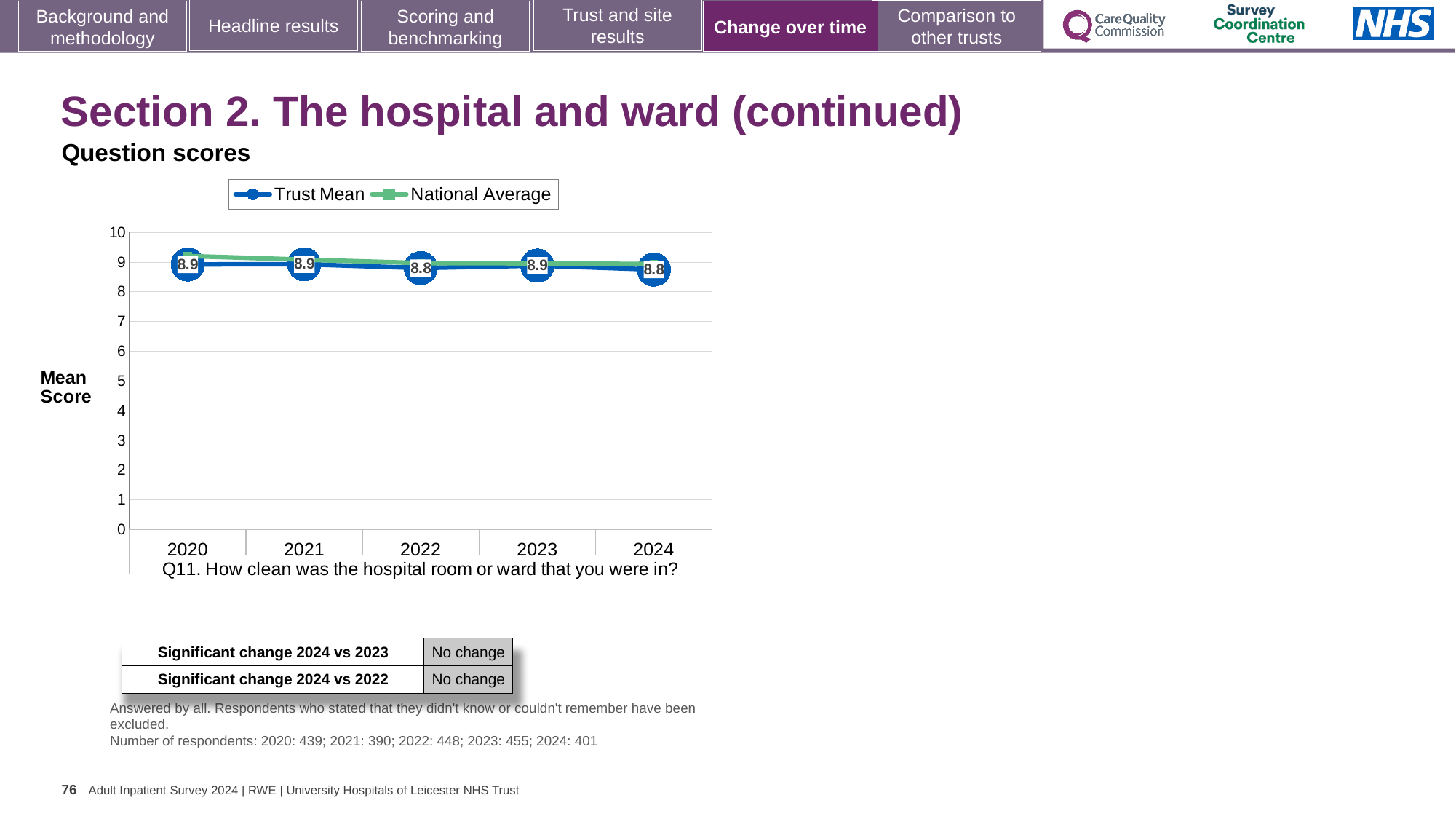
What is the Trust Mean score for 2023? 8.9 What is the difference between the Trust Mean scores for 2021 and 2022? 0.1 What is the label on the vertical axis of the chart? Mean Score What is the Trust Mean score for 2024? 8.8 Is the National Average value for 2024 greater or less than 8? greater Which year has the larger Trust Mean score, 2023 or 2024? 2023 How many years are plotted on the x axis of the chart? 5 How many series does the chart legend list? 2 What is the Trust Mean score for 2022? 8.8 What is the Trust Mean score for 2020? 8.9 What are the two series named in the chart legend? Trust Mean and National Average What kind of chart is shown on the slide? Line chart